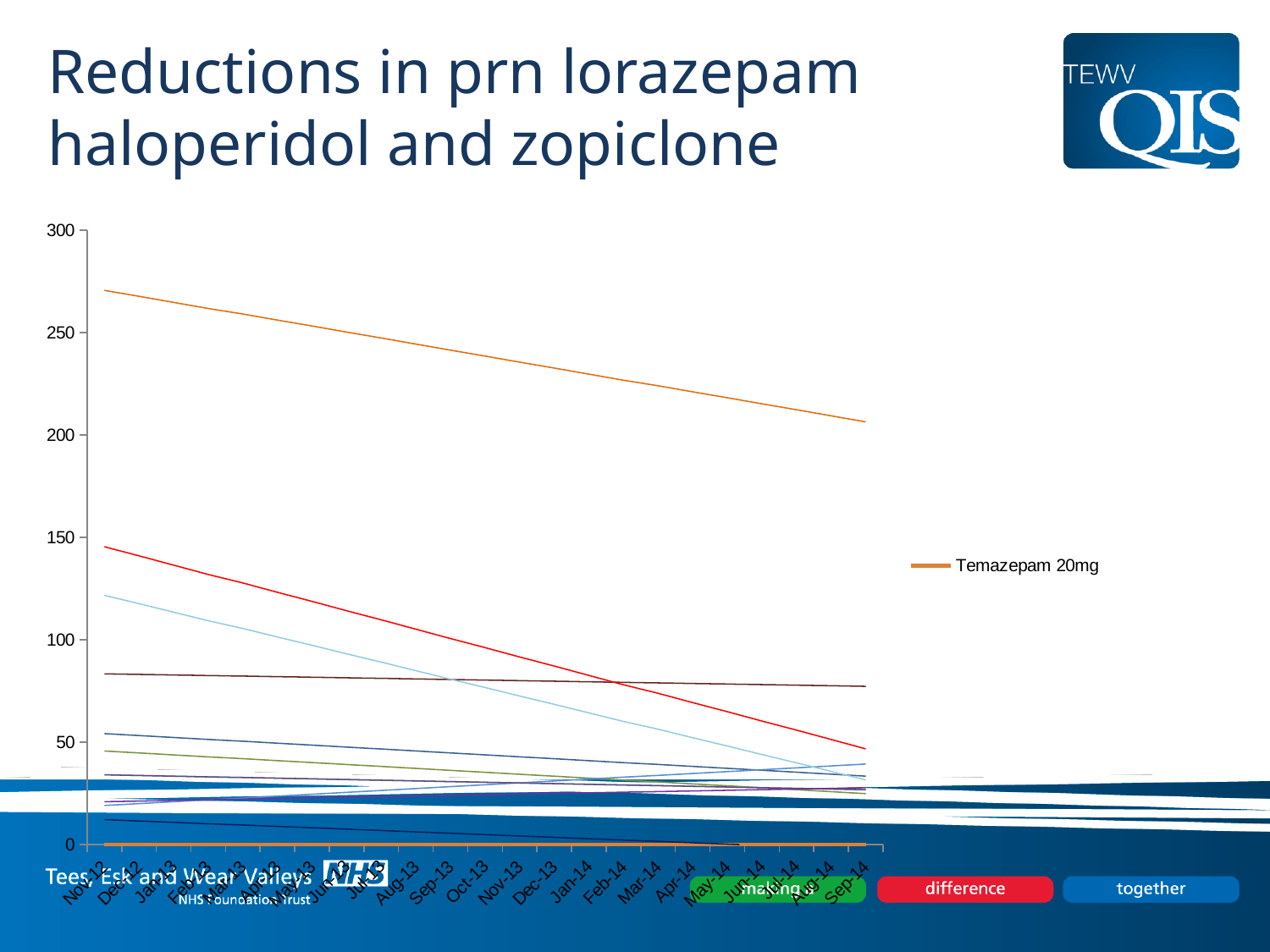
Is the value for Temazepam 20mg at Sep-14 greater or less than 250? less Is the value for Temazepam 20mg at Sep-14 greater or less than 150? less Is the value for Temazepam 20mg at Nov-12 greater or less than 250? less What kind of chart is shown on the slide? line chart How many series does the legend list? 1 What is the highest value shown on the y axis? 300 Is the Temazepam 20mg line the highest line on the chart? no Which series is listed in the chart's legend? Temazepam 20mg